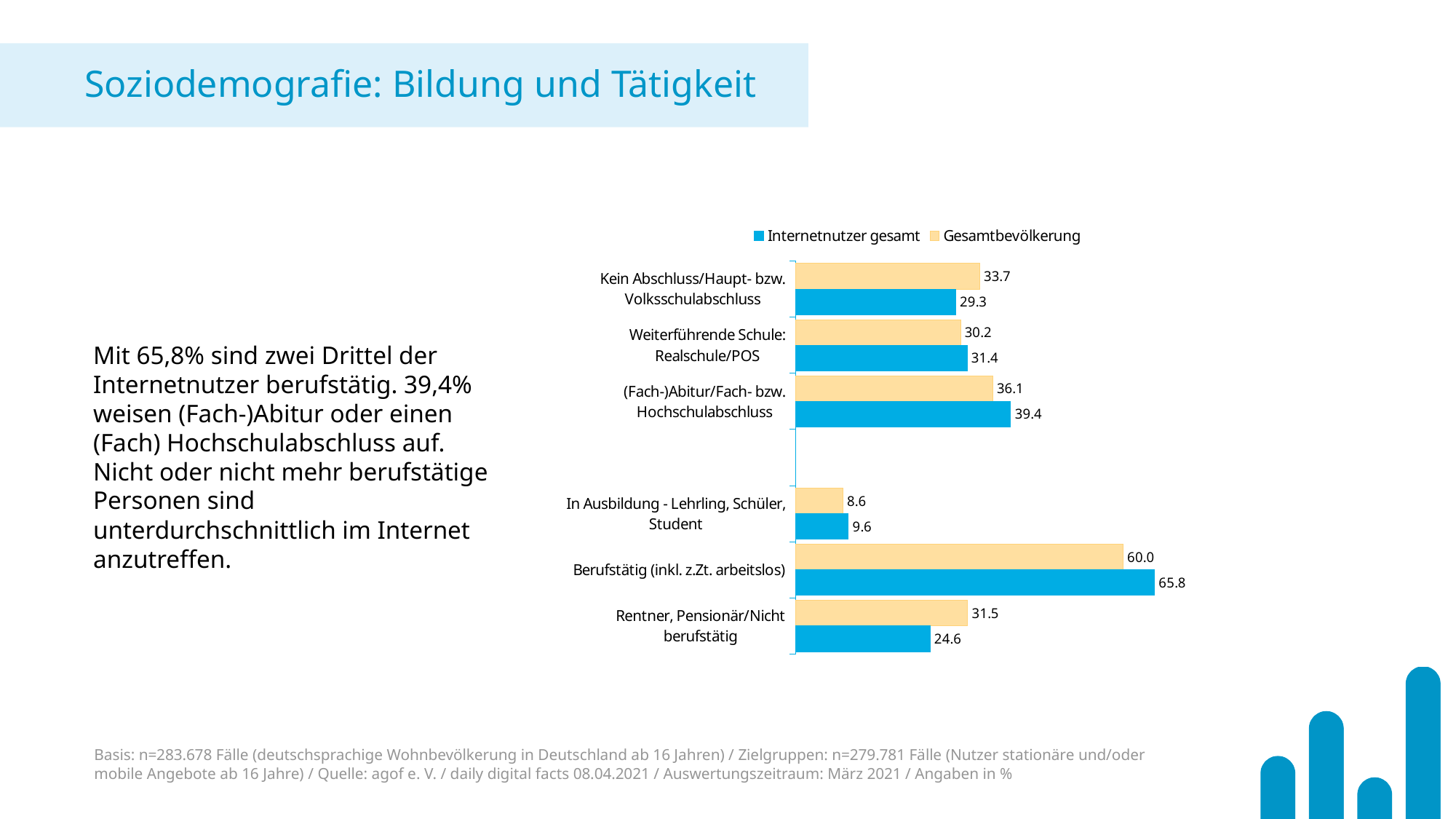
Which category has the highest value for Internetnutzer gesamt? Berufstätig (inkl. z.Zt. arbeitslos) What is the value for Internetnutzer gesamt in the category Berufstätig (inkl. z.Zt. arbeitslos)? 65.8 How many categories are shown in the chart? 6 In the category (Fach-)Abitur/Fach- bzw. Hochschulabschluss, which series has the larger value: Internetnutzer gesamt or Gesamtbevölkerung? Internetnutzer gesamt What is the difference between Internetnutzer gesamt and Gesamtbevölkerung in the category Berufstätig (inkl. z.Zt. arbeitslos)? 5.8 What is the value for Internetnutzer gesamt in the category Rentner, Pensionär/Nicht berufstätig? 24.6 What is the value for Gesamtbevölkerung in the category Kein Abschluss/Haupt- bzw. Volksschulabschluss? 33.7 In the category Rentner, Pensionär/Nicht berufstätig, which series has the larger value: Internetnutzer gesamt or Gesamtbevölkerung? Gesamtbevölkerung What is the value for Gesamtbevölkerung in the category In Ausbildung - Lehrling, Schüler, Student? 8.6 Which category has the lowest value for Gesamtbevölkerung? In Ausbildung - Lehrling, Schüler, Student What kind of chart is shown on the slide? Bar chart How many series does the legend list? 2